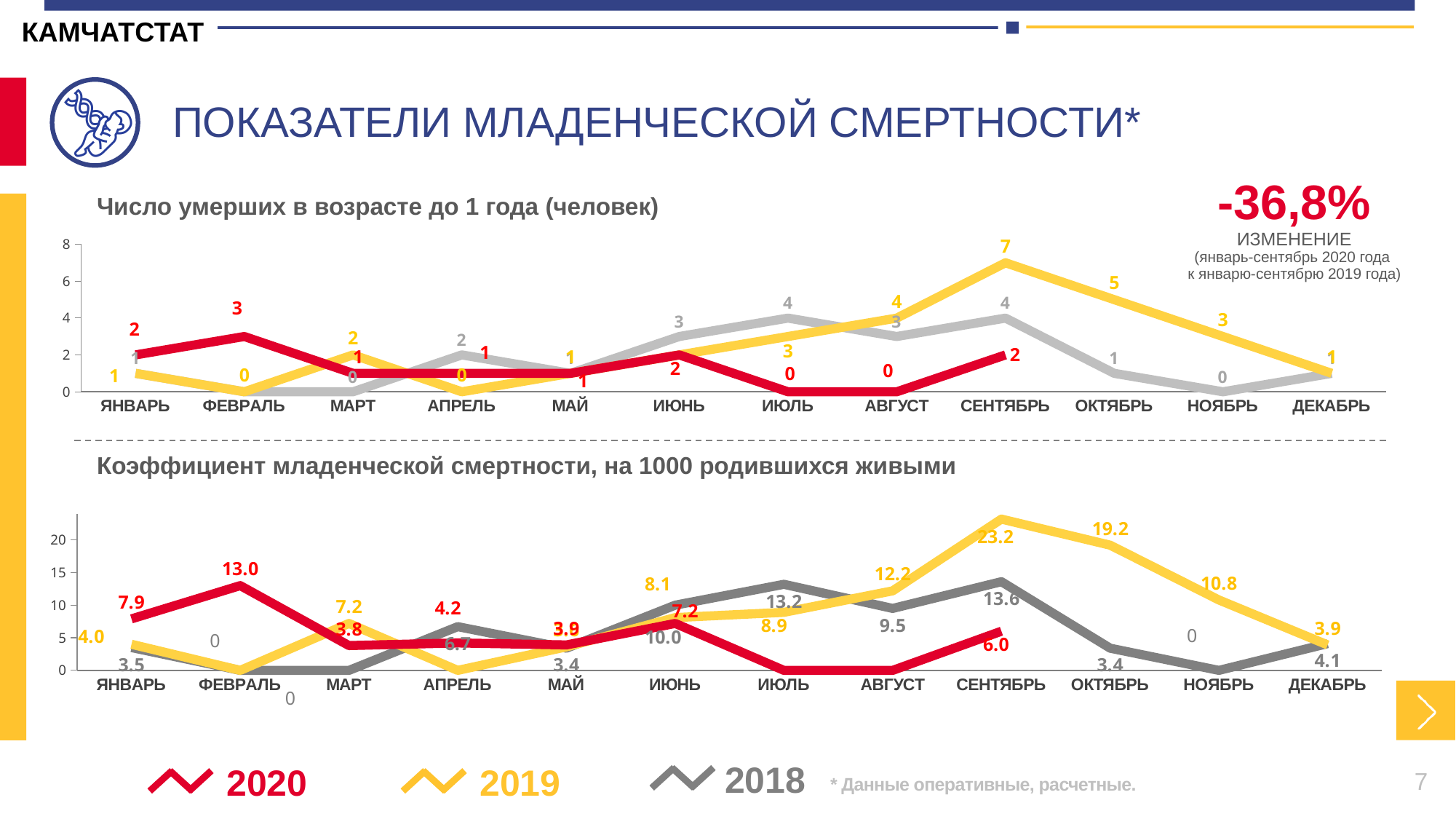
In the top chart (Число умерших в возрасте до 1 года), in which month does the 2019 series reach its highest value? СЕНТЯБРЬ In the bottom chart (Коэффициент младенческой смертности), what is the value for 2020 in ФЕВРАЛЬ? 13.0 In the bottom chart (Коэффициент младенческой смертности), which is larger in ИЮЛЬ: the 2018 value or the 2019 value? 2018 What type of chart is the top chart (Число умерших в возрасте до 1 года)? Line chart In the bottom chart (Коэффициент младенческой смертности), what is the difference between the 2020 value in ФЕВРАЛЬ and the 2020 value in ЯНВАРЬ? 5.1 In the top chart (Число умерших в возрасте до 1 года), what is the value for 2019 in СЕНТЯБРЬ? 7 What percentage change is shown in the top right of the slide? -36,8% In the top chart (Число умерших в возрасте до 1 года), what is the difference between the 2019 value and the 2020 value in СЕНТЯБРЬ? 5 In the bottom chart (Коэффициент младенческой смертности), which series has the highest value in СЕНТЯБРЬ? 2019 How many series does the legend list? 3 In the top chart (Число умерших в возрасте до 1 года), what is the value for 2020 in ФЕВРАЛЬ? 3 In the bottom chart (Коэффициент младенческой смертности), what is the value for 2019 in ОКТЯБРЬ? 19.2